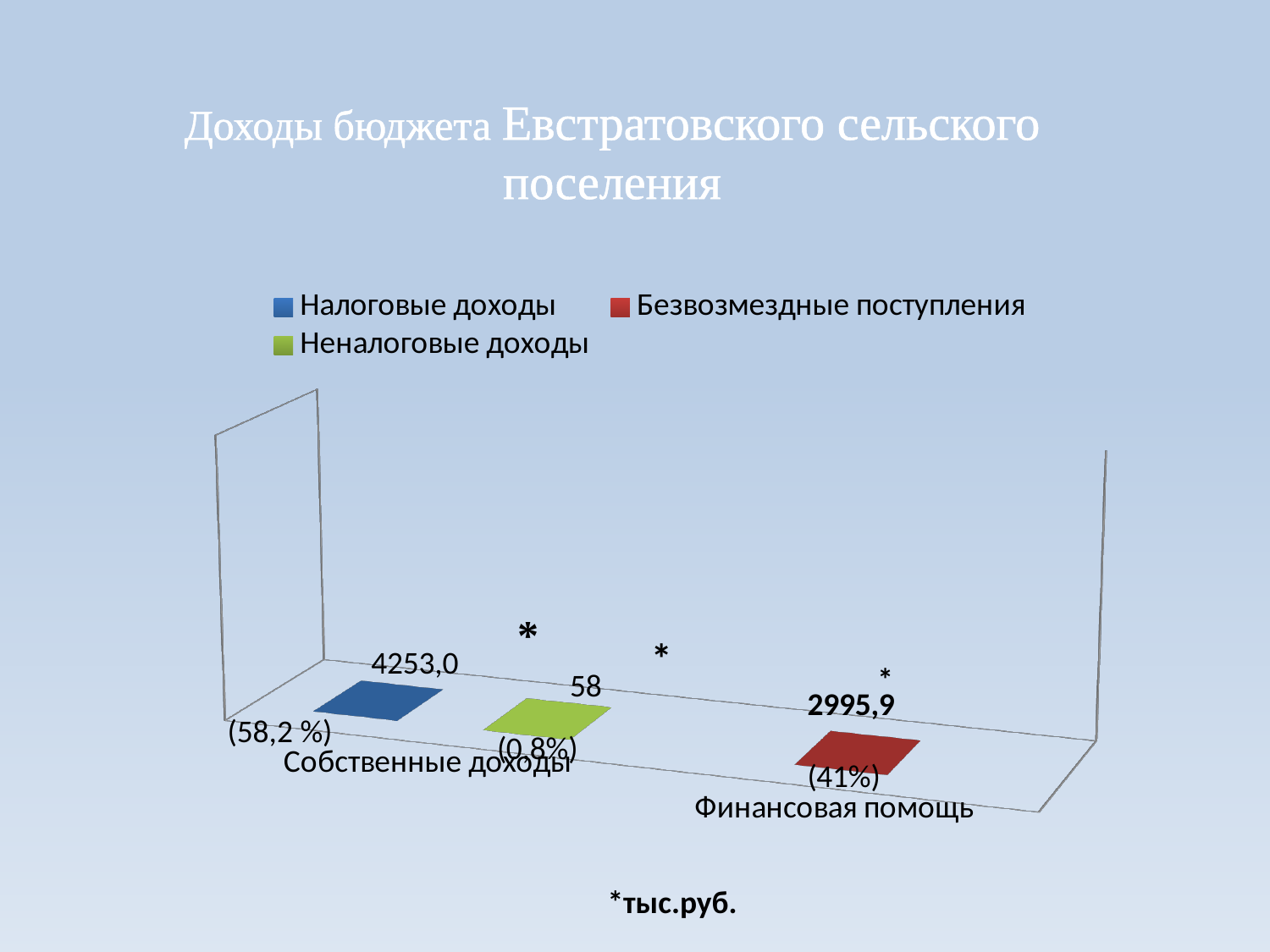
What percentage share is shown next to Безвозмездные поступления? 41% What unit is indicated by the asterisk footnote below the chart? тыс.руб. What is the difference between the values for Налоговые доходы and Безвозмездные поступления? 1257,1 What percentage share is shown next to Налоговые доходы? 58,2 % Which series has the highest value? Налоговые доходы How many categories are shown on the x axis? 2 How many series does the legend list? 3 What is the value shown for Налоговые доходы? 4253,0 What is the value shown for Безвозмездные поступления? 2995,9 What is the value shown for Неналоговые доходы? 58 Which is larger, the value for Неналоговые доходы or the value for Безвозмездные поступления? Безвозмездные поступления Which series has the lowest value? Неналоговые доходы